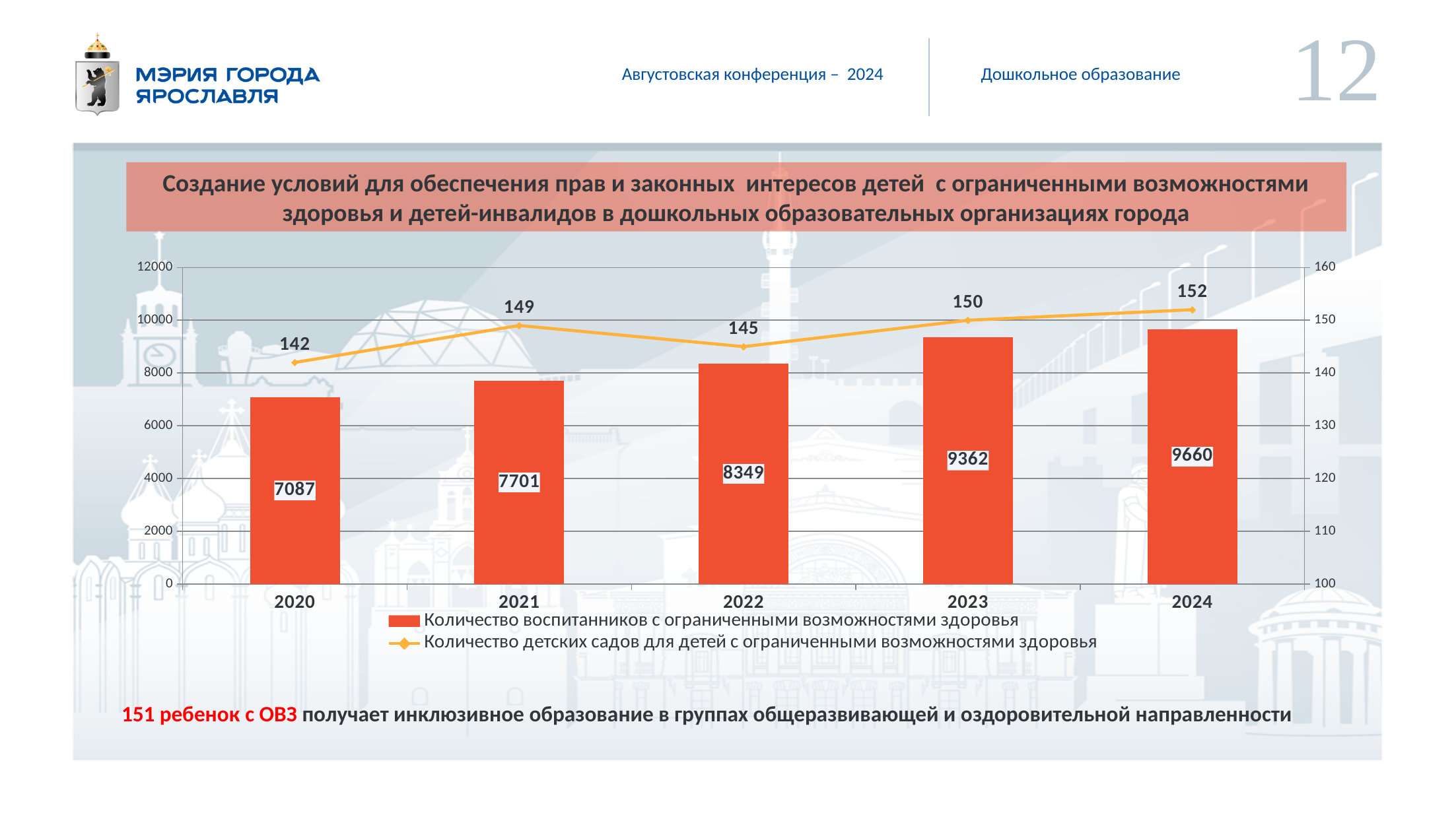
By how much did the number of pupils with limited health capabilities increase from 2020 to 2024? 2573 Which is larger: the number of kindergartens in 2023 or in 2022? 2023 How many kindergartens for children with limited health capabilities were there in 2021? 149 What is the value of the bar for 2024? 9660 What is the number of pupils with limited health capabilities (Количество воспитанников с ограниченными возможностями здоровья) in 2022? 8349 How many series does the legend list? 2 Which year has the lowest number of kindergartens for children with limited health capabilities? 2020 What colour are the bars in the chart? Red (orange-red) Does the number of pupils with limited health capabilities rise or fall from 2020 to 2024? rise What is the difference in the number of kindergartens between 2021 and 2022? 4 Which year has the highest number of pupils with limited health capabilities? 2024 How many years are shown on the x axis? 5